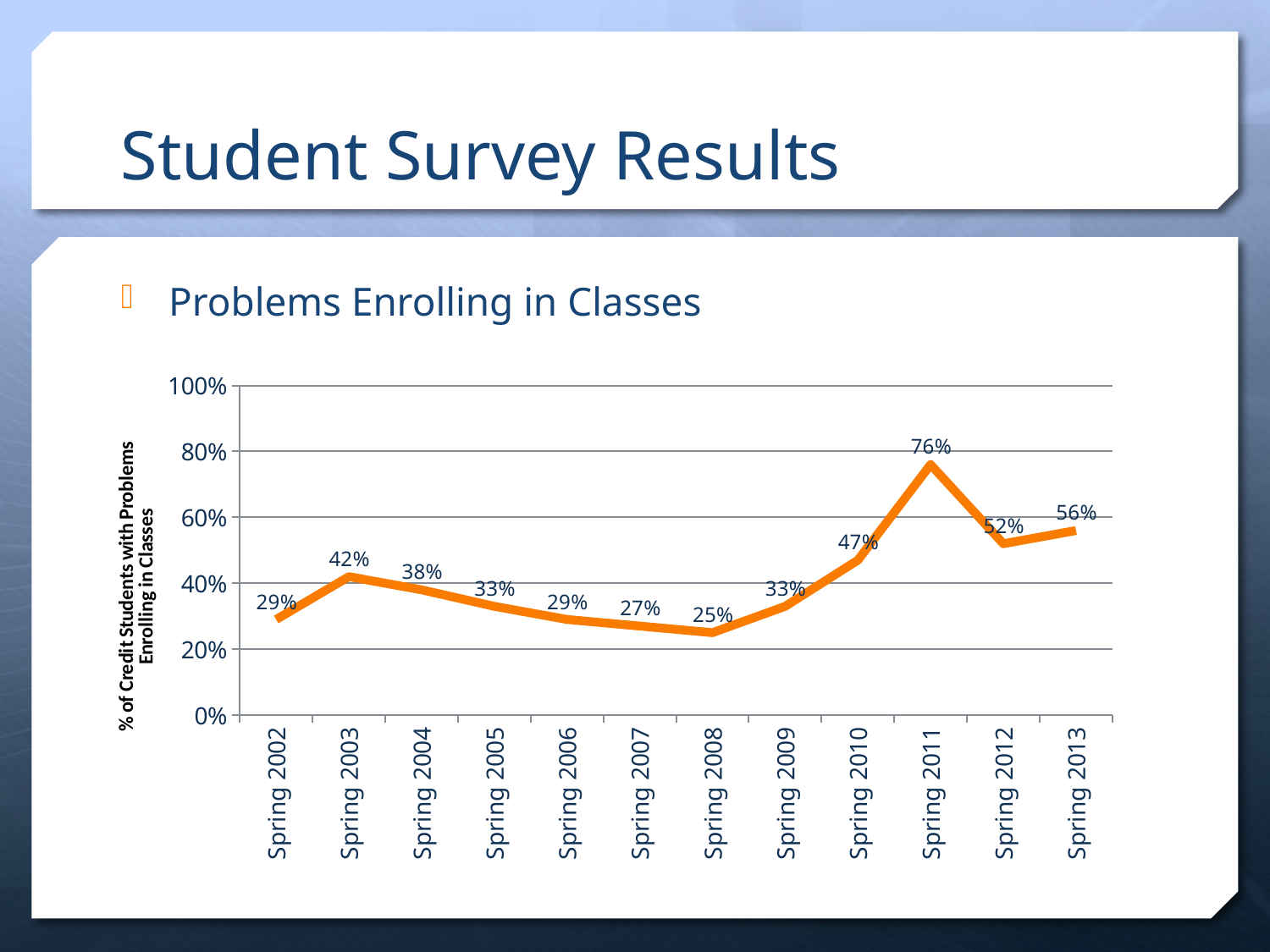
Do the values rise or fall from Spring 2003 to Spring 2008? Fall What percentage of credit students reported problems enrolling in classes in Spring 2011? 76% What is the difference between the values for Spring 2003 and Spring 2002? 13% What kind of chart is shown on the slide? Line chart Which is larger, the value for Spring 2010 or the value for Spring 2009? Spring 2010 Which spring term has the highest percentage of credit students with problems enrolling in classes? Spring 2011 What is the value for Spring 2002? 29% How many spring terms are plotted on the chart? 12 What is the difference between the values for Spring 2011 and Spring 2012? 24% Which spring term has the lowest percentage of credit students with problems enrolling in classes? Spring 2008 What is the value for Spring 2013? 56% Is the value for Spring 2012 greater or less than 40%? greater